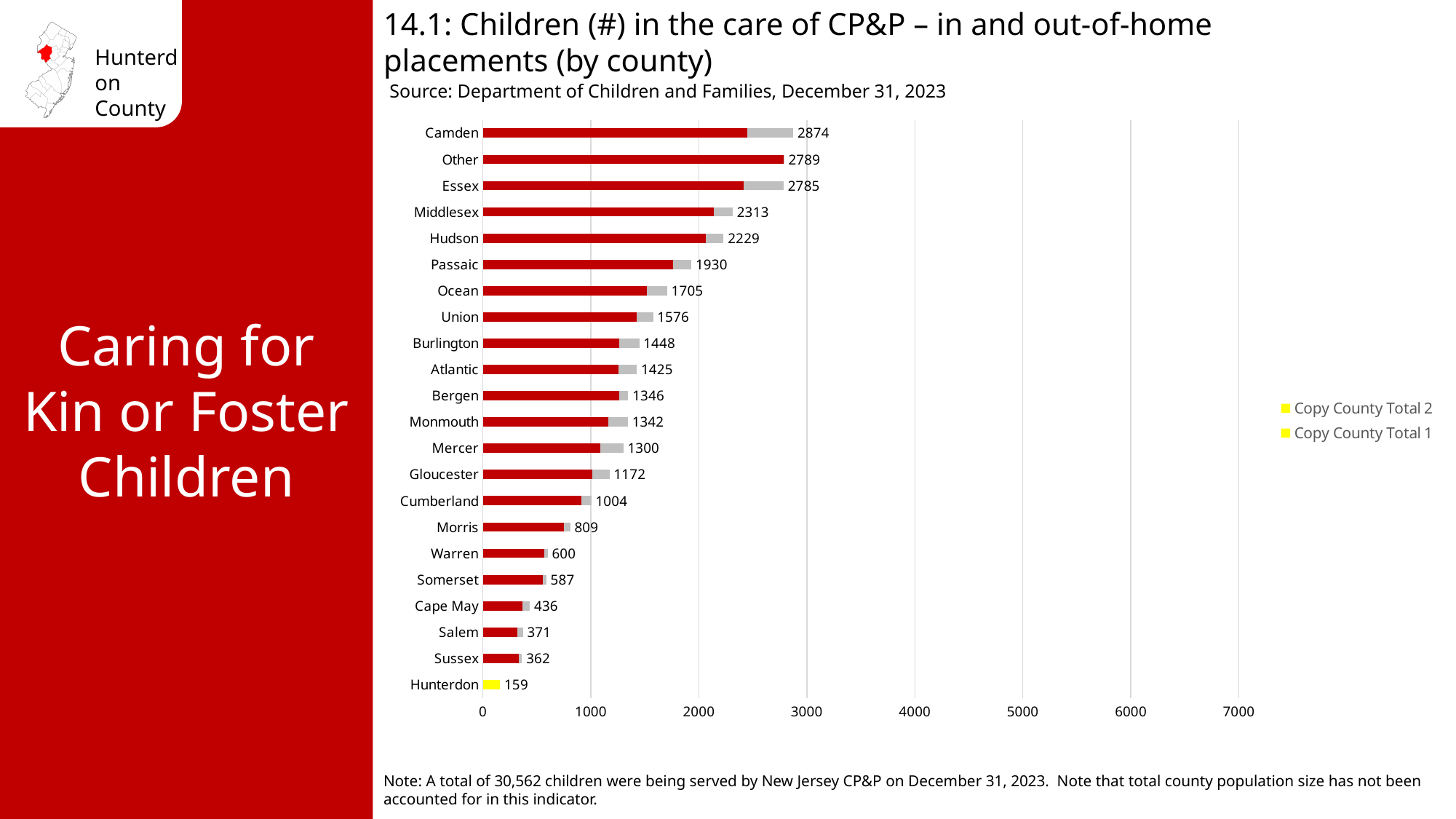
What kind of chart is shown on the slide? Bar chart How many counties (categories) are shown on the chart? 22 Which has a larger total, Ocean or Union? Ocean Is the total for Middlesex greater or less than 2000? greater How many series does the legend list? 2 What is the total number of children in the care of CP&P for Camden? 2874 What is the total number of children in the care of CP&P for Hunterdon? 159 What is the difference between the totals for Camden and Essex? 89 Which county has the highest total number of children in the care of CP&P? Camden Which county has the lowest total number of children in the care of CP&P? Hunterdon What is the total value shown for Passaic? 1930 What is the difference between the totals for Warren and Somerset? 13